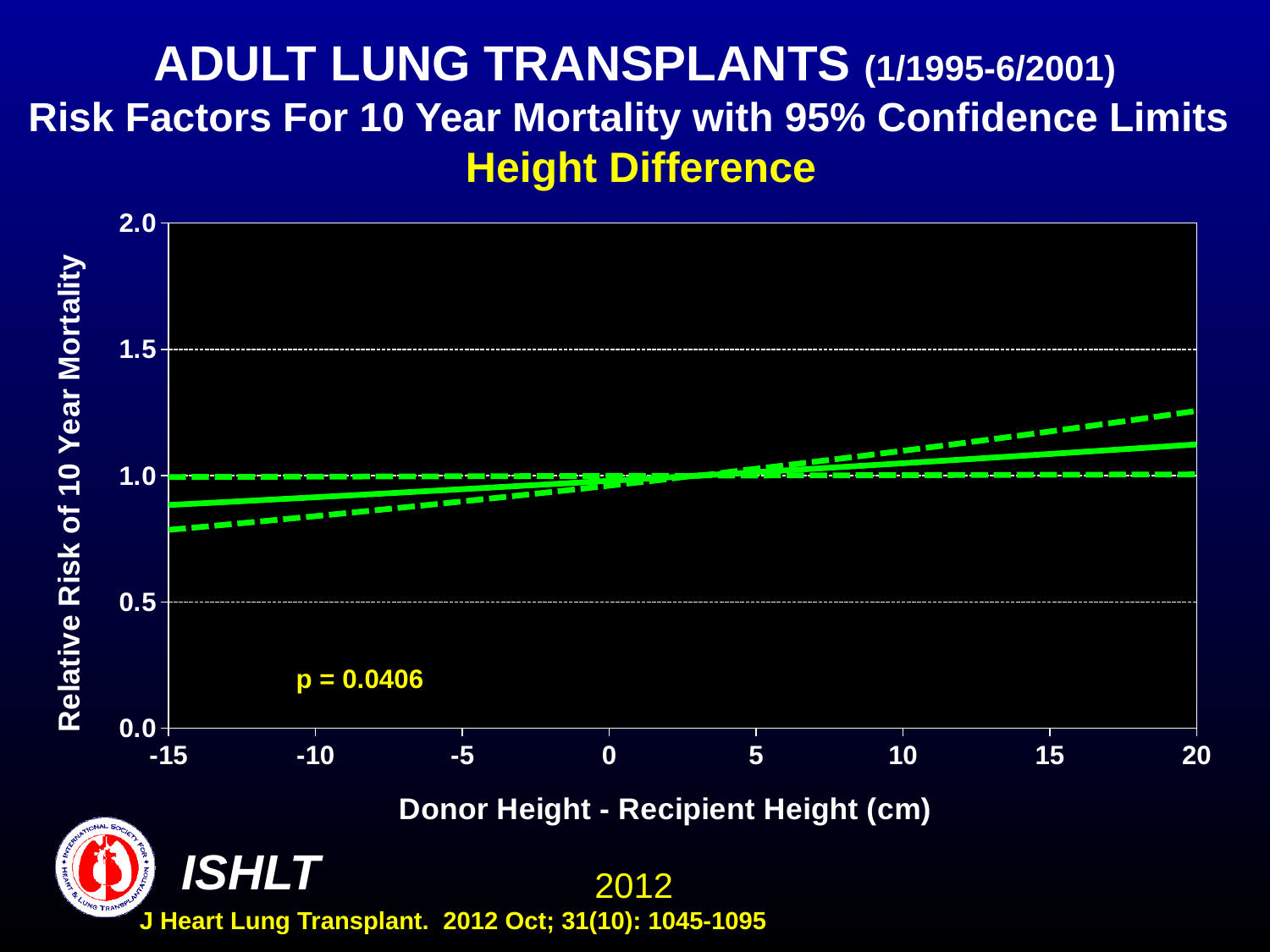
Is the relative risk (solid line) at a height difference of 20 cm greater or less than 1.0? greater Is the lower confidence limit at a height difference of -15 cm greater or less than 0.5? greater What is the label of the x axis? Donor Height - Recipient Height (cm) What is the p-value shown on the chart? p = 0.0406 Does the solid relative risk line rise or fall as Donor Height - Recipient Height increases from -15 to 20 cm? rise Is the relative risk (solid line) at a height difference of -15 cm greater or less than 1.0? less Is the relative risk (solid line) higher at a height difference of 20 cm or at -15 cm? 20 cm What kind of chart is shown on the slide? line chart How many lines are plotted on the chart? 3